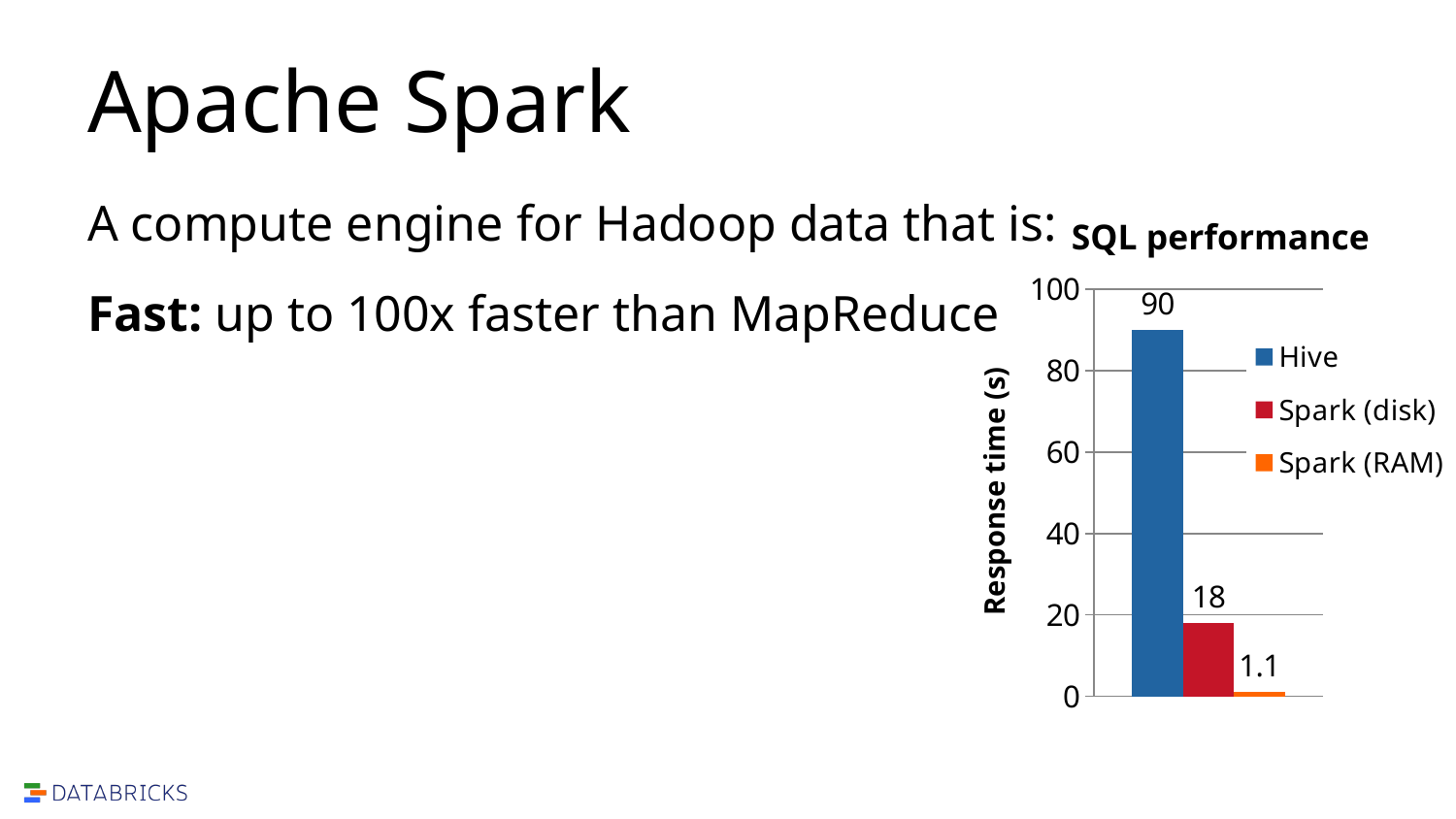
What is the difference in response time between Spark (disk) and Spark (RAM)? 16.9 Which has a larger response time, Hive or Spark (disk)? Hive Is the response time for Spark (disk) greater or less than 20? less What is the response time for Spark (RAM) in the SQL performance chart? 1.1 What is the response time for Spark (disk) in the SQL performance chart? 18 What is the label of the vertical axis in the SQL performance chart? Response time (s) Which series has the highest response time in the SQL performance chart? Hive What is the difference in response time between Hive and Spark (disk)? 72 How many series does the legend of the SQL performance chart list? 3 What kind of chart is the SQL performance chart? bar chart What is the response time for Hive in the SQL performance chart? 90 Which series has the lowest response time in the SQL performance chart? Spark (RAM)